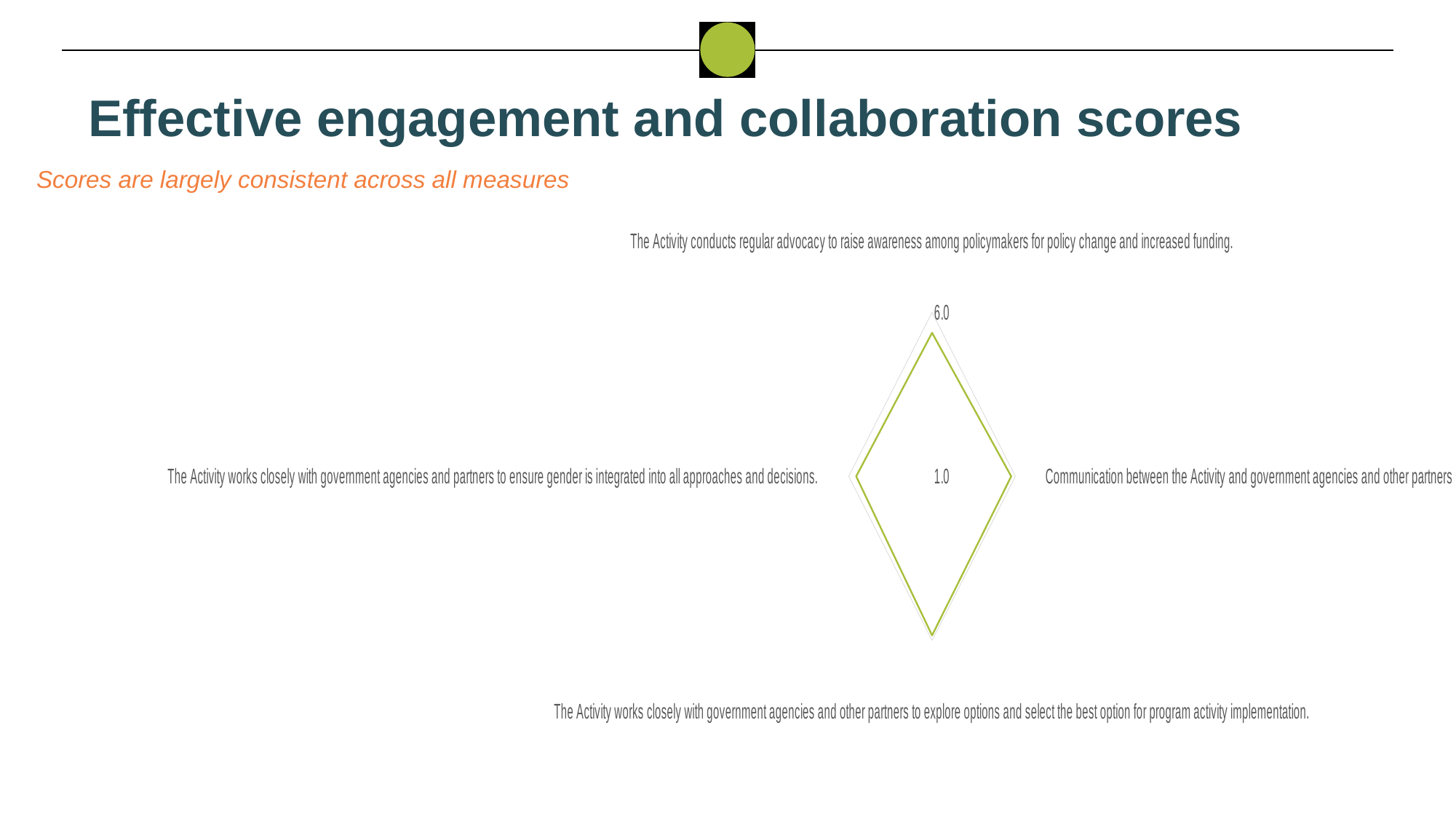
Is the value for 'The Activity works closely with government agencies and partners to ensure gender is integrated into all approaches and decisions.' greater or less than 1.0? greater How many measures (axes) does the radar chart plot? 4 Is the value for 'The Activity conducts regular advocacy to raise awareness among policymakers for policy change and increased funding.' greater or less than 1.0? greater What is the subtitle shown above the radar chart? Scores are largely consistent across all measures What kind of chart is shown on the slide? Radar chart What is the highest axis tick value shown on the radar chart? 6.0 What is the title of the slide containing the radar chart? Effective engagement and collaboration scores Is the value for 'The Activity works closely with government agencies and other partners to explore options and select the best option for program activity implementation.' greater or less than 1.0? greater